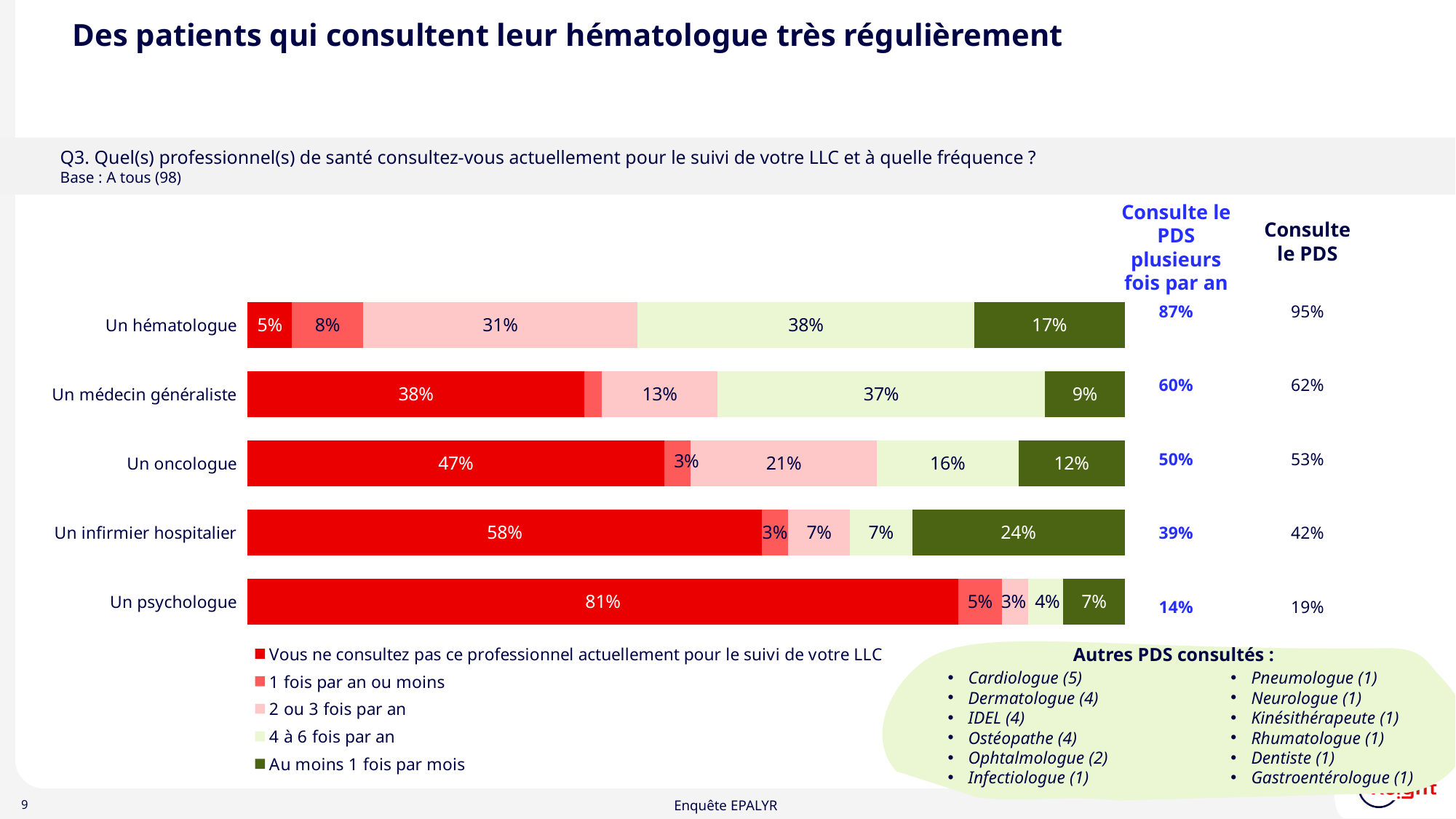
What is the 'Consulte le PDS plusieurs fois par an' value for 'Un médecin généraliste'? 60% Which professional has the highest share of respondents who do not consult them ('Vous ne consultez pas ce professionnel')? Un psychologue What kind of chart is shown on the slide? Stacked bar chart What percentage of respondents do not currently consult 'Un psychologue' for their LLC follow-up? 81% How many health professionals (categories) are shown in the chart? 5 How many series does the legend list? 5 For 'Au moins 1 fois par mois', which is larger: 'Un infirmier hospitalier' or 'Un oncologue'? Un infirmier hospitalier What is the first entry in the chart legend? Vous ne consultez pas ce professionnel actuellement pour le suivi de votre LLC What percentage of respondents consult 'Un hématologue' at least once a month ('Au moins 1 fois par mois')? 17% What is the difference in the '4 à 6 fois par an' share between 'Un hématologue' and 'Un oncologue'? 22 percentage points What is the '2 ou 3 fois par an' value for 'Un oncologue'? 21% Which professional has the lowest share of respondents who do not consult them? Un hématologue